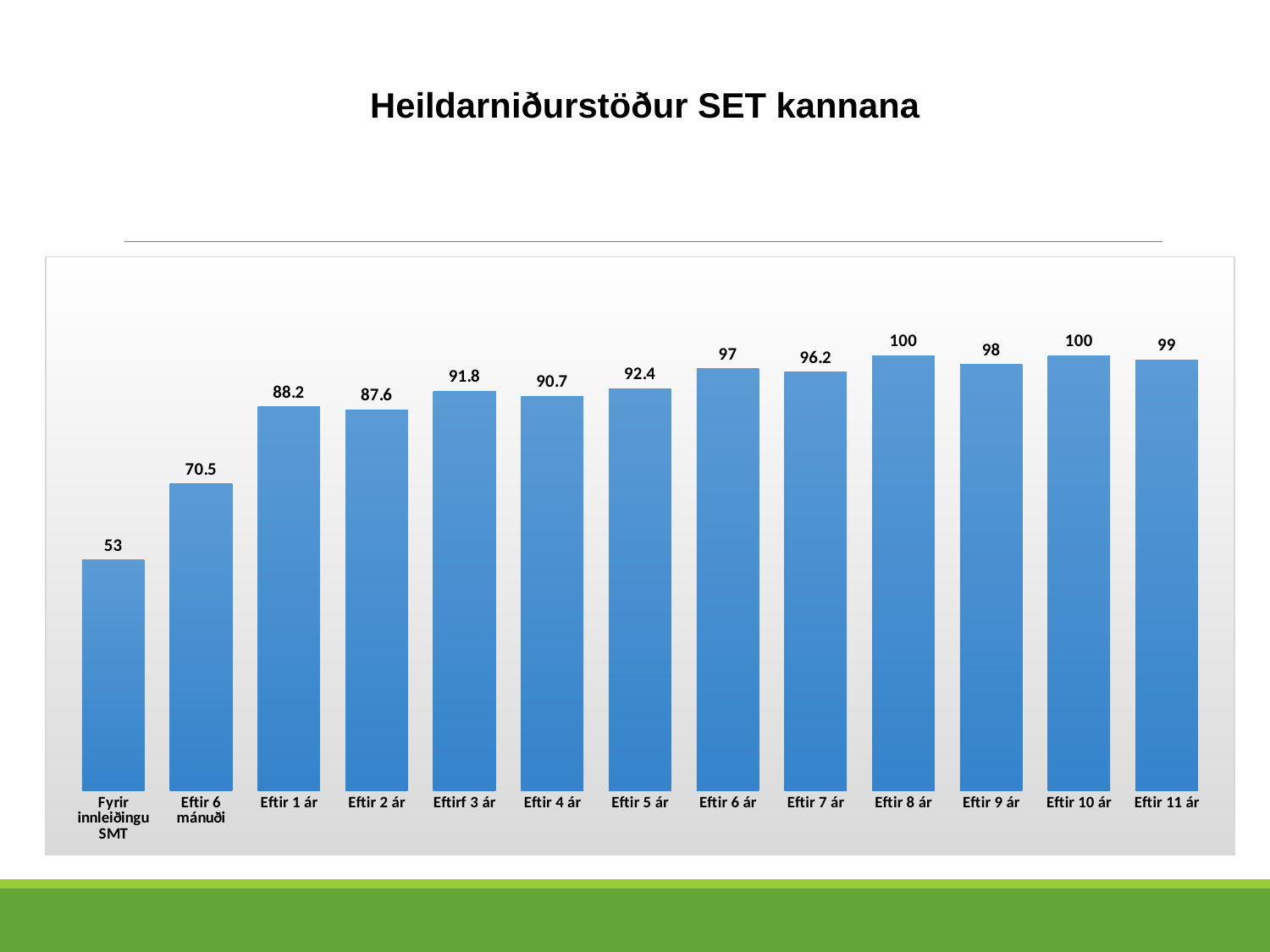
What is the value for 'Fyrir innleiðingu SMT'? 53 What is the value for 'Eftir 5 ár'? 92.4 What is the difference between the values for 'Eftir 8 ár' and 'Fyrir innleiðingu SMT'? 47 Which is larger, the value for 'Eftir 1 ár' or 'Eftir 2 ár'? Eftir 1 ár What is the value for 'Eftir 11 ár'? 99 How many categories are shown in the chart? 13 Which category has the lowest value? Fyrir innleiðingu SMT What is the highest value shown in the chart? 100 What is the title of the slide? Heildarniðurstöður SET kannana What kind of chart is shown on the slide? Bar chart What is the value for 'Eftir 6 mánuði'? 70.5 What is the difference between the values for 'Eftir 6 mánuði' and 'Fyrir innleiðingu SMT'? 17.5